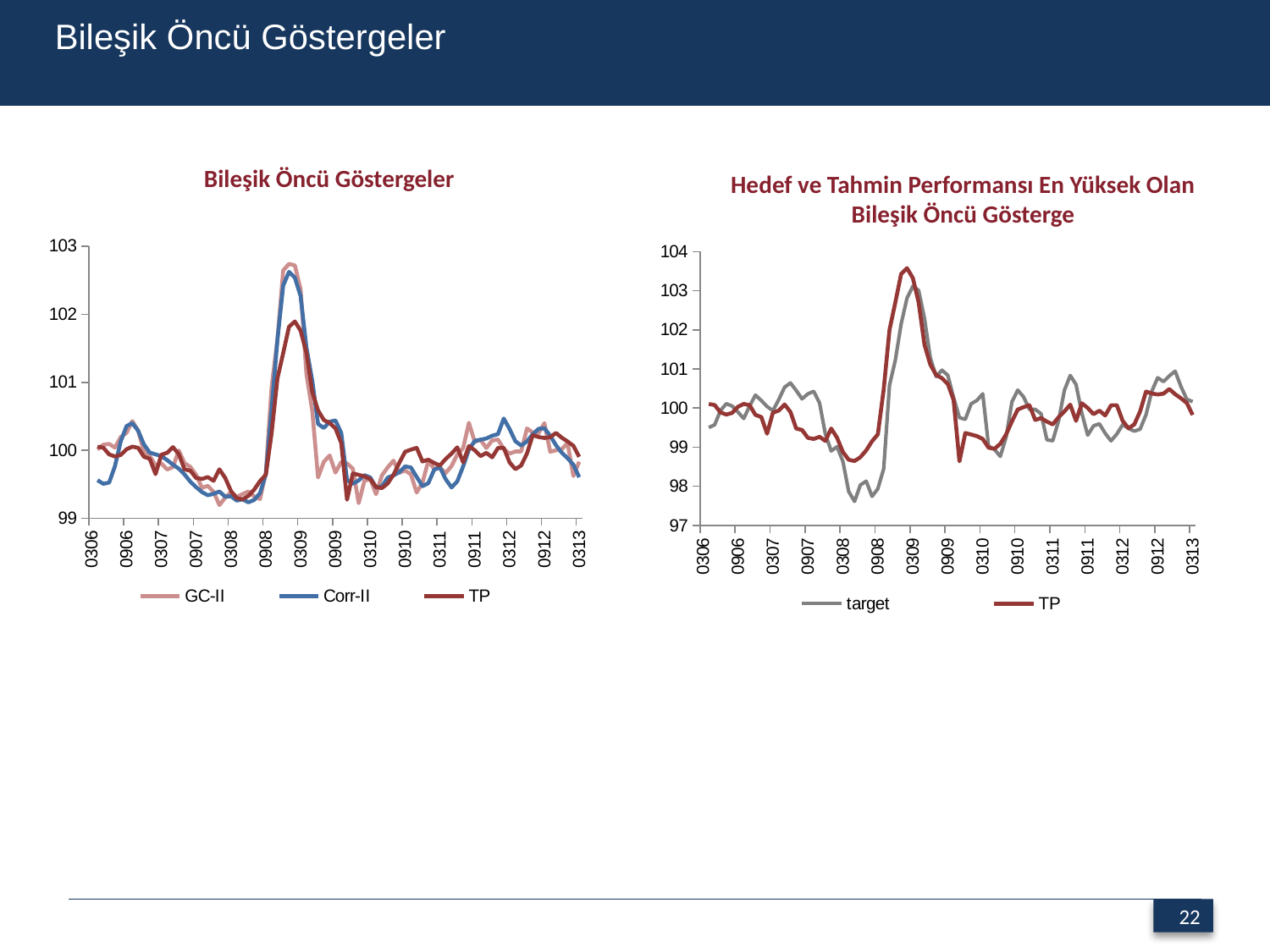
How many series does the legend of the right chart "Hedef ve Tahmin Performansı En Yüksek Olan Bileşik Öncü Gösterge" list? 2 Which series are listed in the legend of the left chart "Bileşik Öncü Göstergeler"? GC-II, Corr-II, TP In the left chart "Bileşik Öncü Göstergeler", around which x-axis label do all three series reach their highest values? 0309 In the right chart "Hedef ve Tahmin Performansı En Yüksek Olan Bileşik Öncü Gösterge", which series drops lower around 0308, target or TP? target Which series are listed in the legend of the right chart "Hedef ve Tahmin Performansı En Yüksek Olan Bileşik Öncü Gösterge"? target, TP In the left chart "Bileşik Öncü Göstergeler", is the peak value of TP around 0309 greater or less than 102? less What kind of chart is the left chart titled "Bileşik Öncü Göstergeler"? line chart In the right chart "Hedef ve Tahmin Performansı En Yüksek Olan Bileşik Öncü Gösterge", is the lowest value of the target series around 0308 greater or less than 98? less How many series does the legend of the left chart "Bileşik Öncü Göstergeler" list? 3 In the right chart "Hedef ve Tahmin Performansı En Yüksek Olan Bileşik Öncü Gösterge", is the peak value of TP around 0309 greater or less than 103? greater In the left chart "Bileşik Öncü Göstergeler", which series reaches a higher peak around 0309, GC-II or TP? GC-II